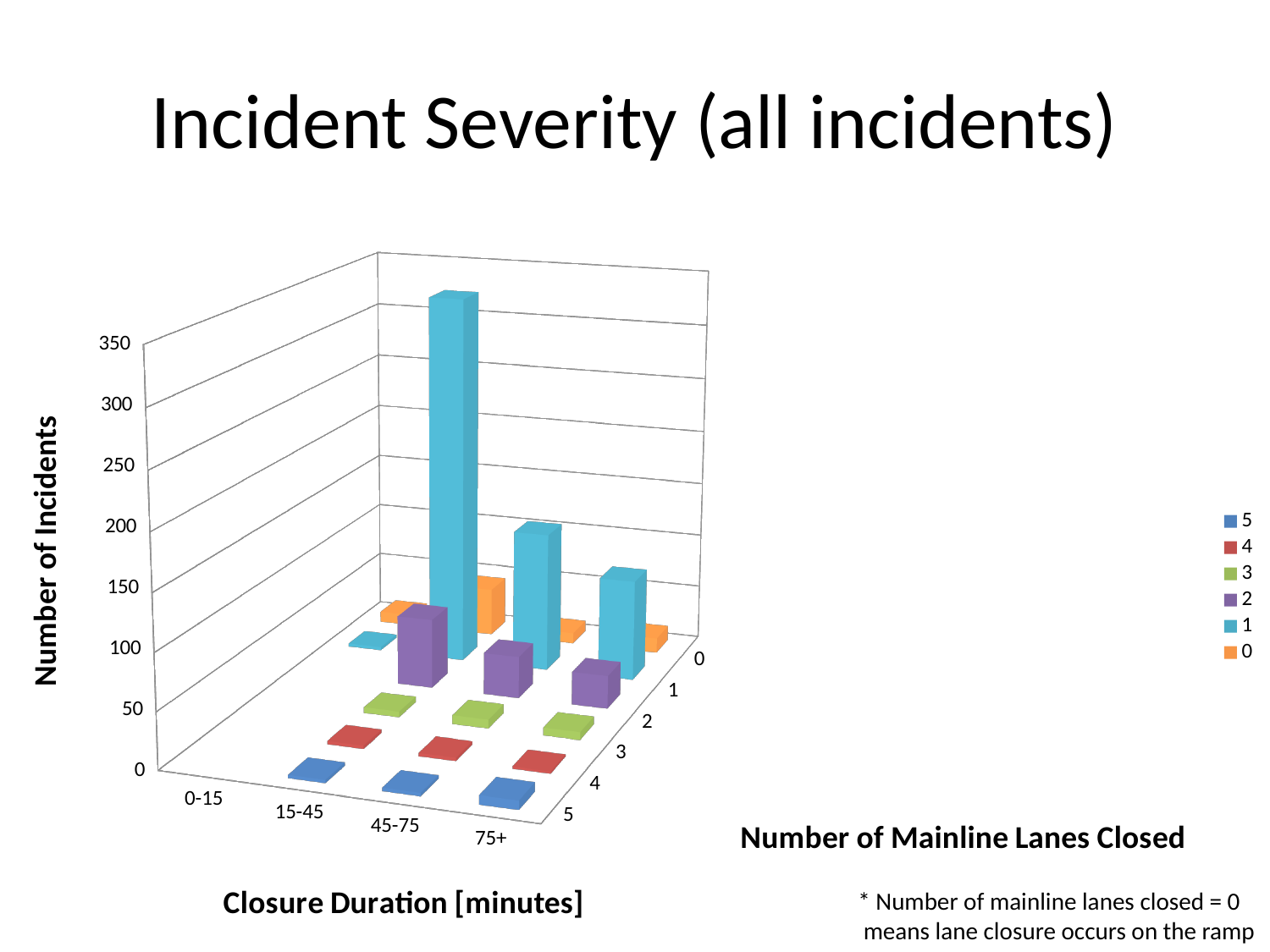
For a 15-45 minute closure, which has more incidents: 1 lane closed or 2 lanes closed? 1 lane closed How many closure duration categories are shown on the x axis? 4 What is the title of the chart? Incident Severity (all incidents) Which number of mainline lanes closed has the tallest bar in the chart? 1 Which closure duration has the highest number of incidents for 1 mainline lane closed? 15-45 Is the number of incidents for 1 lane closed with a 15-45 minute closure greater or less than 200? greater Is the number of incidents for 2 lanes closed with a 15-45 minute closure greater or less than 150? less Is the number of incidents for 1 lane closed with a 45-75 minute closure greater or less than 200? less For 1 mainline lane closed, which has more incidents: the 15-45 minute closure or the 45-75 minute closure? 15-45 How many series does the legend list? 6 What is the title of the vertical axis? Number of Incidents What kind of chart is shown on the slide? bar chart